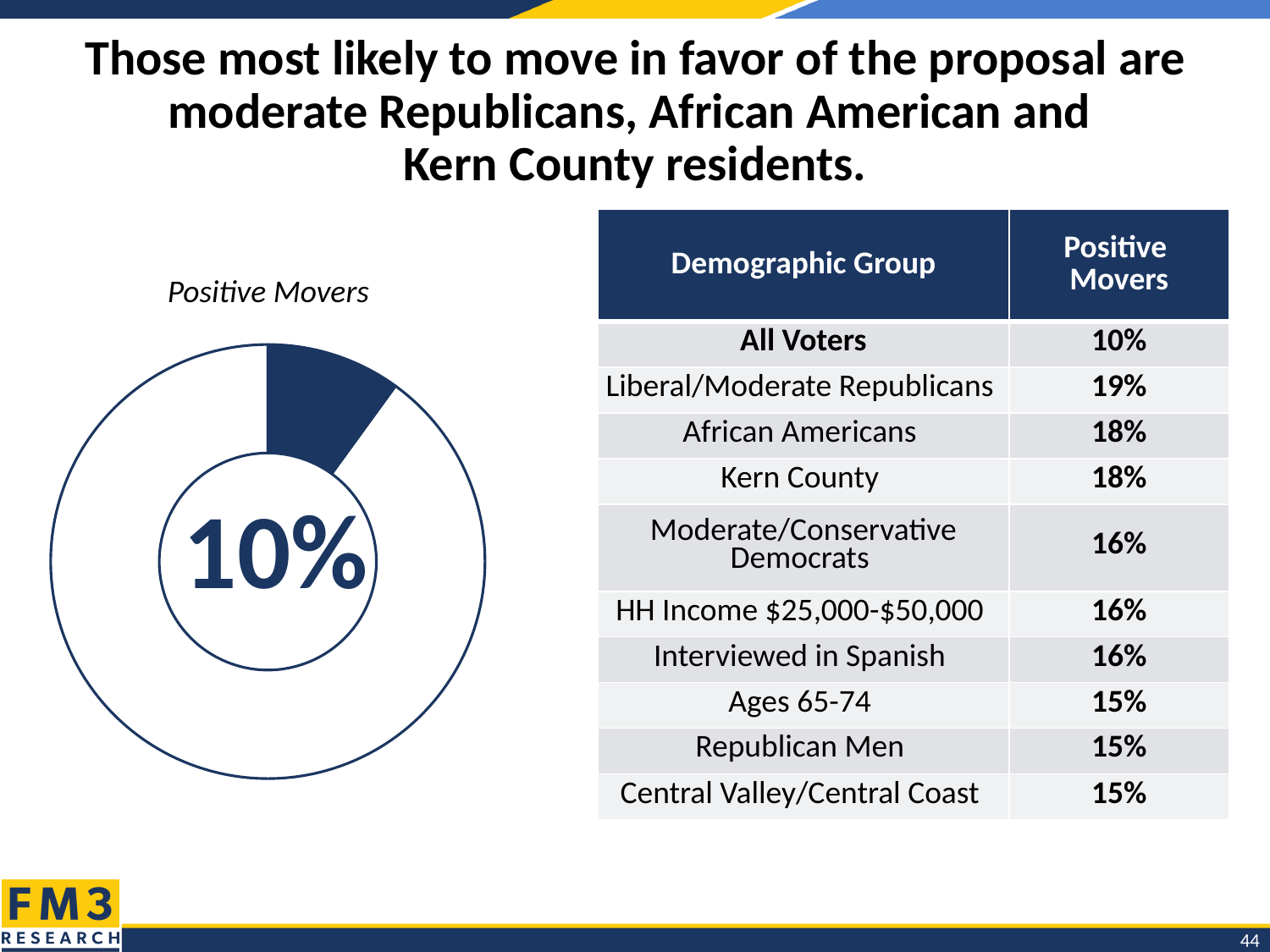
What is the title of the donut chart? Positive Movers How many filled slices does the donut chart show? 1 What share of the donut chart does the filled (dark) slice represent? 10% What value is printed in the center of the donut chart? 10% What kind of chart is shown on the left of the slide? donut chart What colour is the filled slice of the donut chart? dark navy blue Is the filled slice of the donut chart larger or smaller than the unfilled remainder? smaller